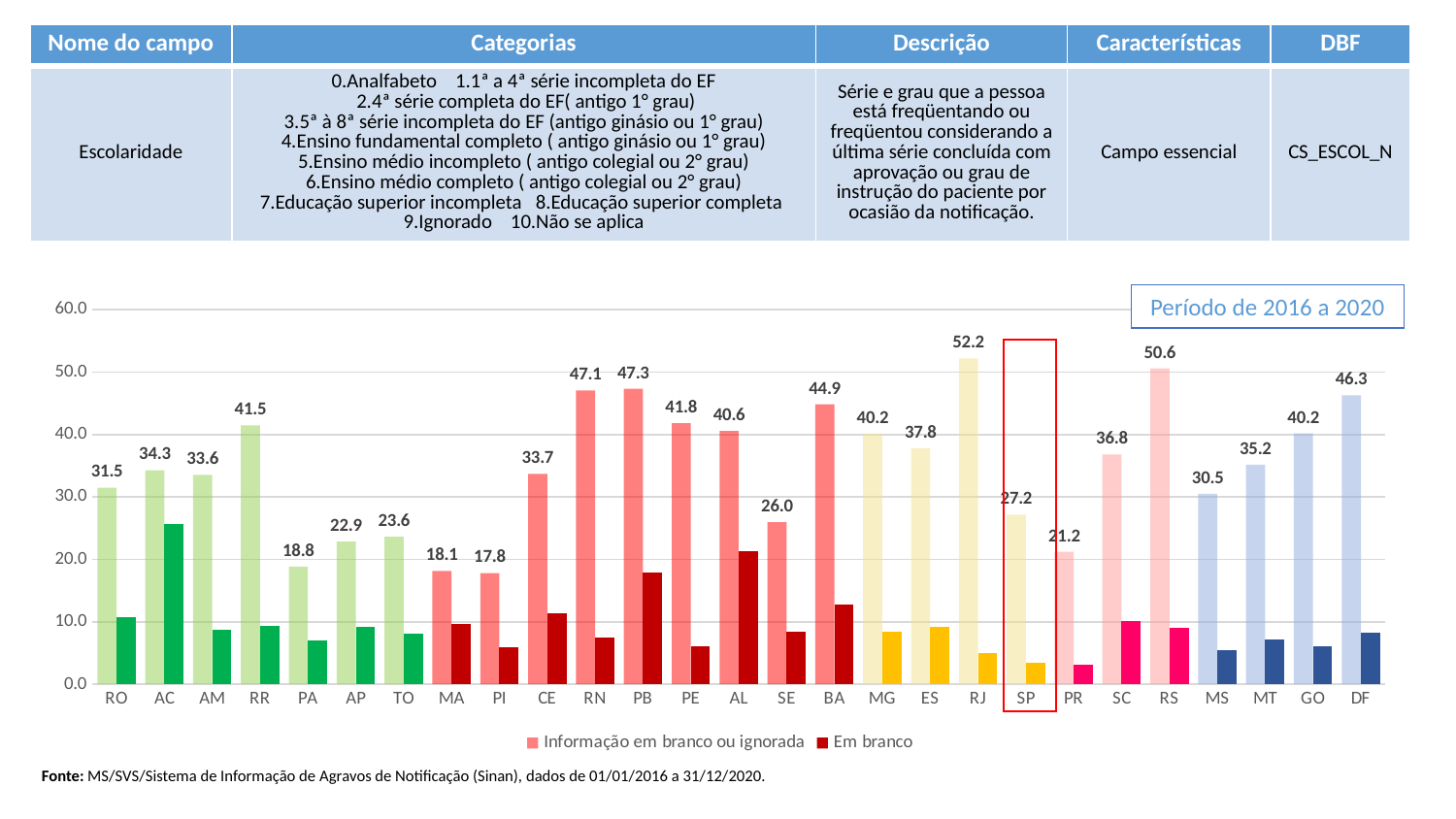
What is the value of "Informação em branco ou ignorada" for SP? 27.2 Which state has the highest value for "Informação em branco ou ignorada"? RJ How many states are shown on the x axis of the chart? 27 Is the "Em branco" value for AC greater or less than 20.0? greater What is the value of "Informação em branco ou ignorada" for RJ? 52.2 Which state has the lowest value for "Informação em branco ou ignorada"? PI Which has a higher "Informação em branco ou ignorada" value, PB or PE? PB How many series does the chart legend list? 2 What period does the chart cover, according to the box in the top right? Período de 2016 a 2020 Is the "Em branco" value for PA greater or less than 10.0? less What is the value of "Informação em branco ou ignorada" for RS? 50.6 What is the difference between the "Informação em branco ou ignorada" values for RJ and SP? 25.0